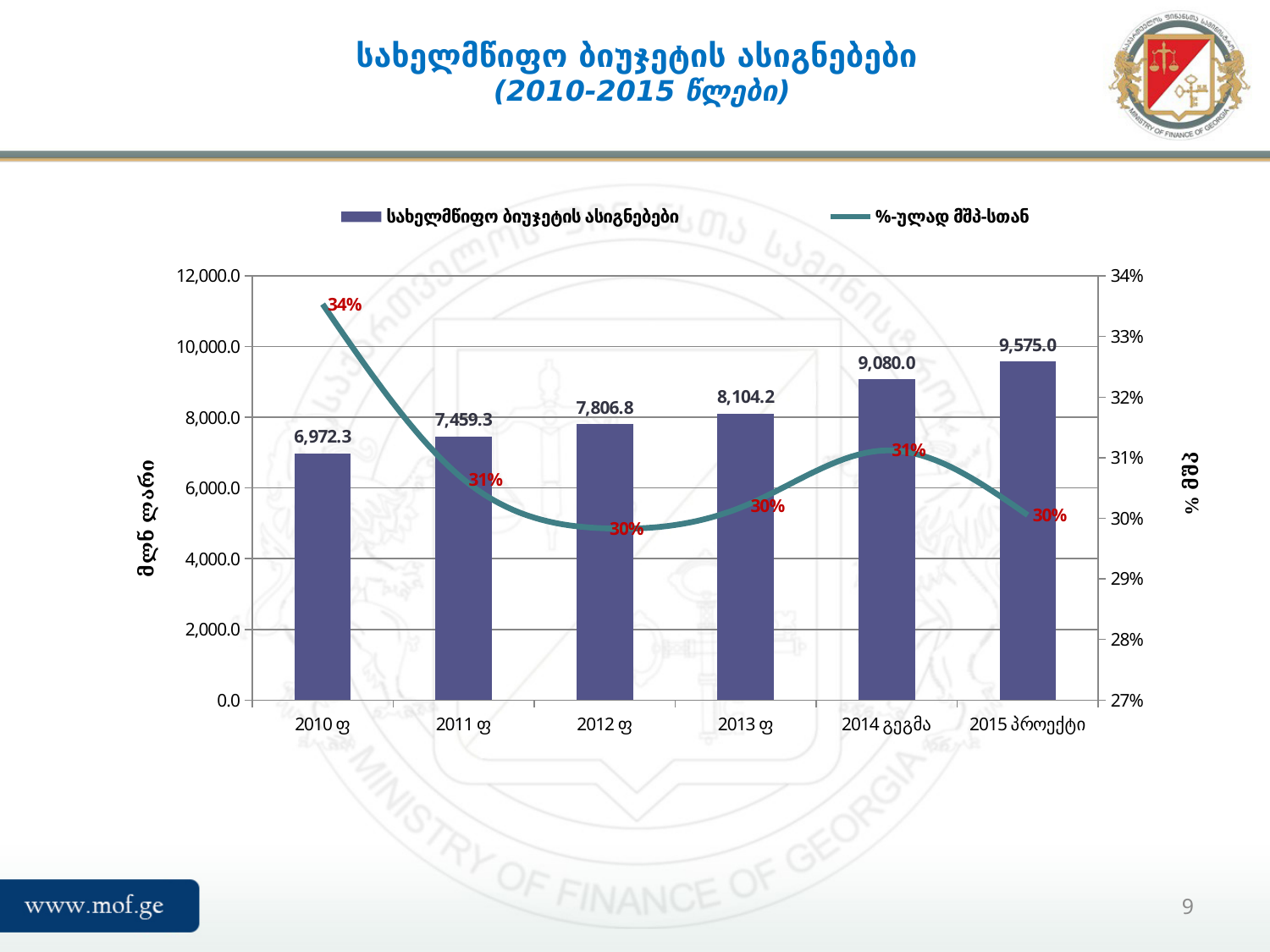
What is the value of the bar for 2010 ფ? 6,972.3 Which category has the lowest bar value? 2010 ფ Do the bar values rise or fall from 2010 ფ to 2015 პროექტი? rise What is the value of the bar for 2014 გეგმა? 9,080.0 What is the difference between the bar values for 2015 პროექტი and 2014 გეგმა? 495.0 Which is larger, the bar value for 2012 ფ or for 2013 ფ? 2013 ფ What percentage does the line series show for 2013 ფ? 30% Which category has the highest bar value? 2015 პროექტი How many series does the legend list? 2 What is the label of the left vertical axis? მლნ ლარი What percentage does the line series show for 2010 ფ? 34% How many categories are shown on the x axis? 6